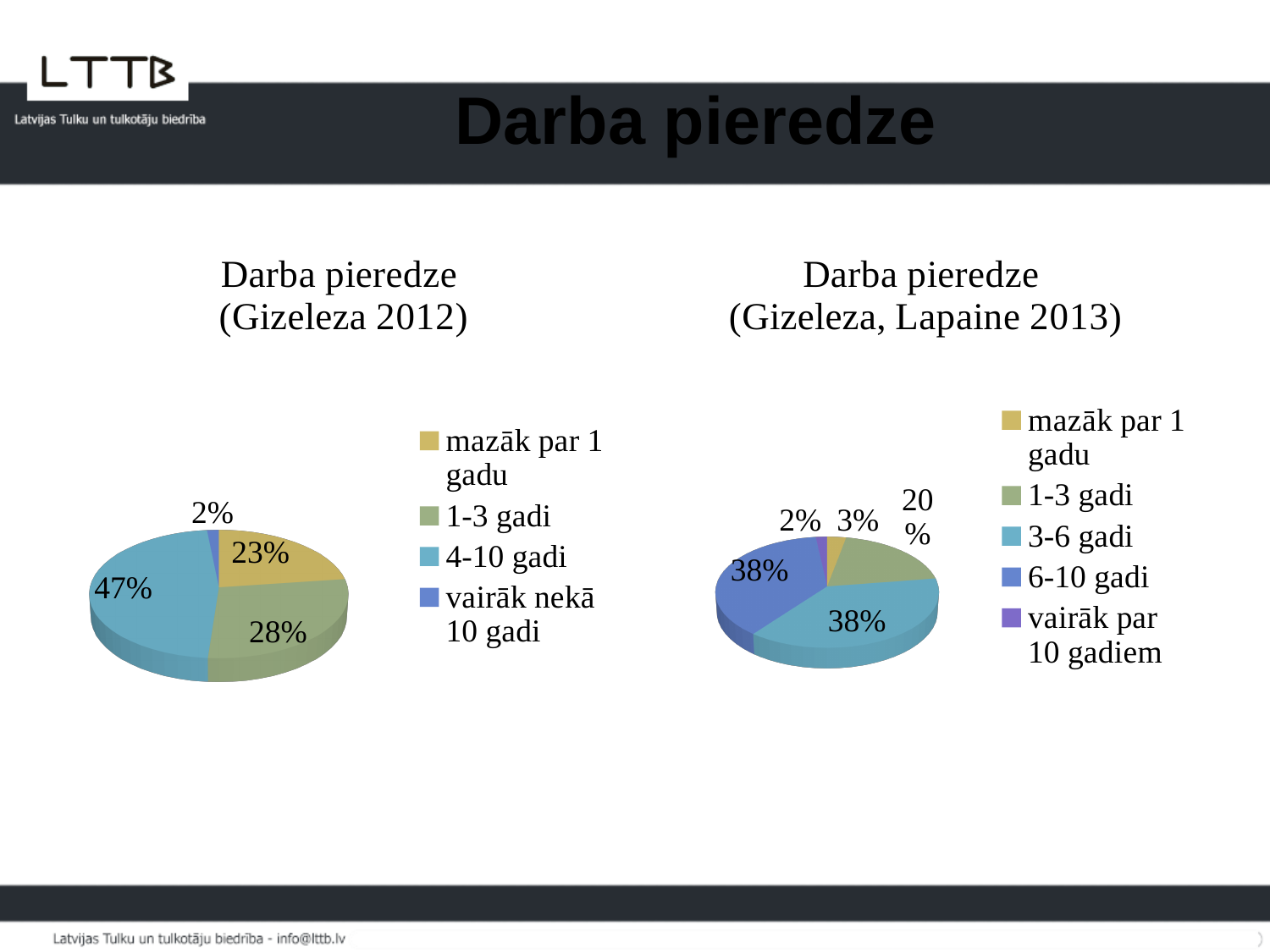
In the chart titled "Darba pieredze (Gizeleza 2012)", how many categories does the legend list? 4 In the chart titled "Darba pieredze (Gizeleza, Lapaine 2013)", which is larger: the 1-3 gadi slice or the 3-6 gadi slice? 3-6 gadi In the chart titled "Darba pieredze (Gizeleza 2012)", which category has the smallest slice? vairāk nekā 10 gadi In the chart titled "Darba pieredze (Gizeleza 2012)", what share is labelled for the 1-3 gadi slice? 28% What type of chart is used on the left side of the slide, titled "Darba pieredze (Gizeleza 2012)"? Pie chart In the chart titled "Darba pieredze (Gizeleza 2012)", which category has the largest slice? 4-10 gadi In the chart titled "Darba pieredze (Gizeleza, Lapaine 2013)", which category has the smallest slice? vairāk par 10 gadiem In the chart titled "Darba pieredze (Gizeleza, Lapaine 2013)", what share is labelled for the 1-3 gadi slice? 20% In the chart titled "Darba pieredze (Gizeleza 2012)", what is the difference in percentage points between the 4-10 gadi slice and the mazāk par 1 gadu slice? 24 In the chart titled "Darba pieredze (Gizeleza, Lapaine 2013)", what share is labelled for the mazāk par 1 gadu slice? 3% In the chart titled "Darba pieredze (Gizeleza 2012)", what share is labelled for the 4-10 gadi slice? 47% In the chart titled "Darba pieredze (Gizeleza, Lapaine 2013)", how many categories does the legend list? 5